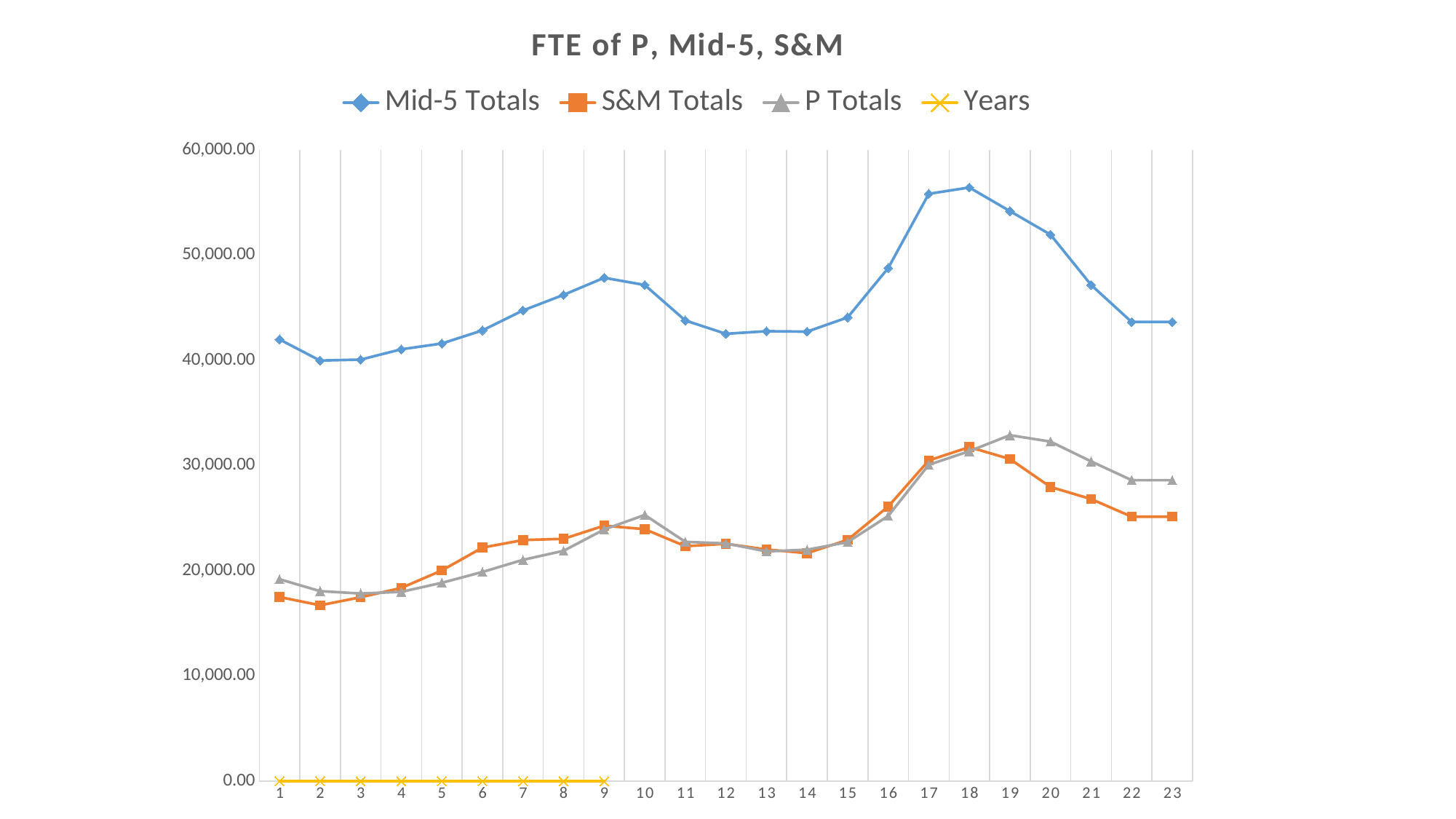
What kind of chart is shown on the slide? Line chart How many points are there along the x axis? 23 At which x-axis point does the S&M Totals series reach its highest value? 18 How many series does the legend list? 4 What is the title of the chart? FTE of P, Mid-5, S&M At point 20, which series has the larger value, P Totals or S&M Totals? P Totals At which x-axis point does the S&M Totals series reach its lowest value? 2 Is the value of Mid-5 Totals at point 18 greater or less than 50,000.00? greater At which x-axis point does the P Totals series reach its highest value? 19 Does the Mid-5 Totals series rise or fall from point 18 to point 22? Fall Is the value of P Totals at point 19 greater or less than 30,000.00? greater Is the value of S&M Totals at point 1 greater or less than 20,000.00? less